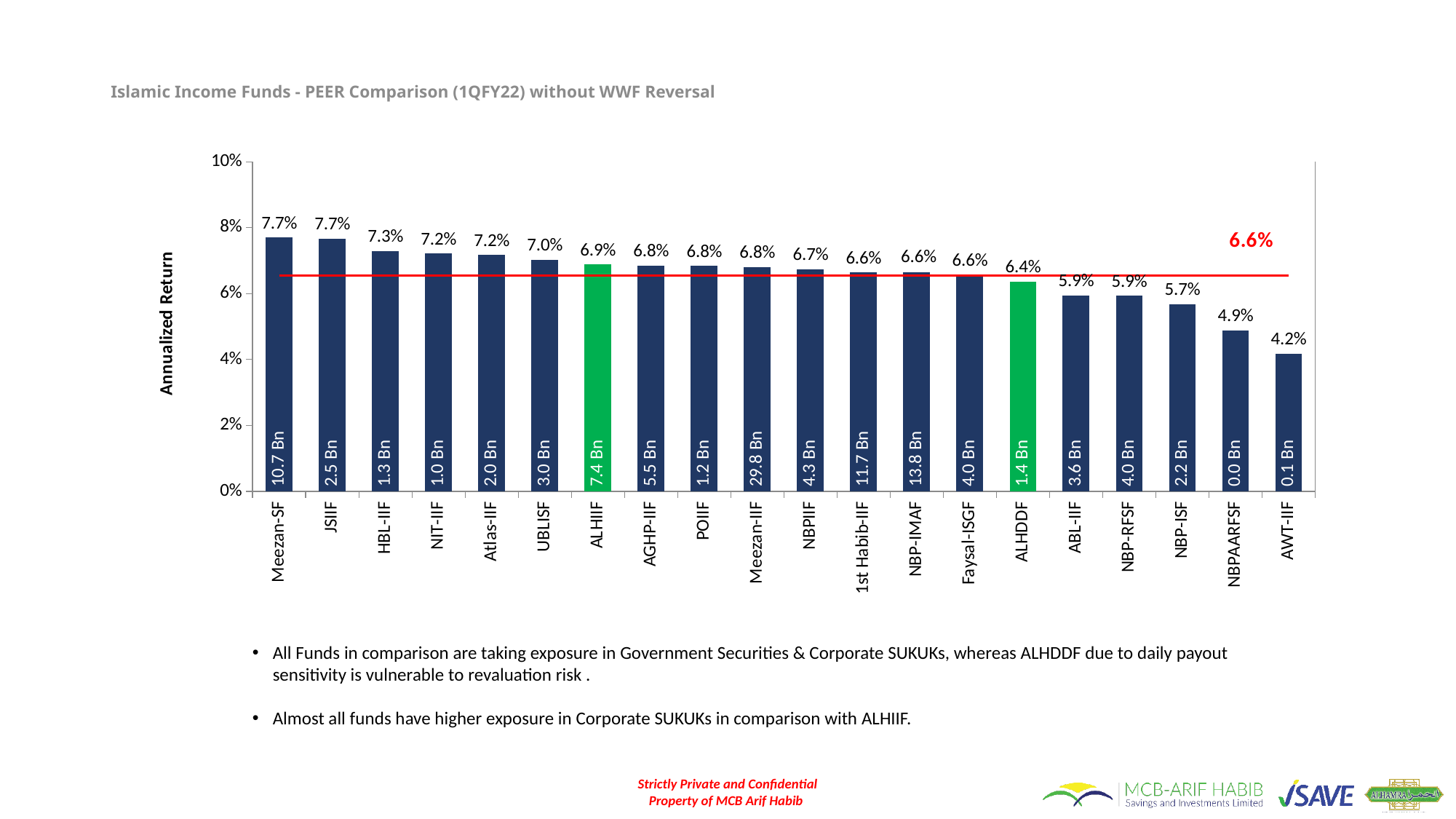
What fund size is printed inside the bar for Meezan-IIF? 29.8 Bn What is the difference between the annualized returns of ALHIIF and ALHDDF? 0.5% How many funds are shown on the chart? 20 What is the annualized return shown for ALHDDF? 6.4% Which fund has the lowest annualized return on the chart? AWT-IIF What is the annualized return shown for NBPAARFSF? 4.9% What kind of chart is shown on the slide? bar chart What is the annualized return shown for ALHIIF? 6.9% Is the annualized return for AWT-IIF greater or less than 6%? less Which has a higher annualized return, UBLISF or ABL-IIF? UBLISF What is the difference between the annualized returns of HBL-IIF and NBP-ISF? 1.6% What value is labelled on the red horizontal line across the chart? 6.6%